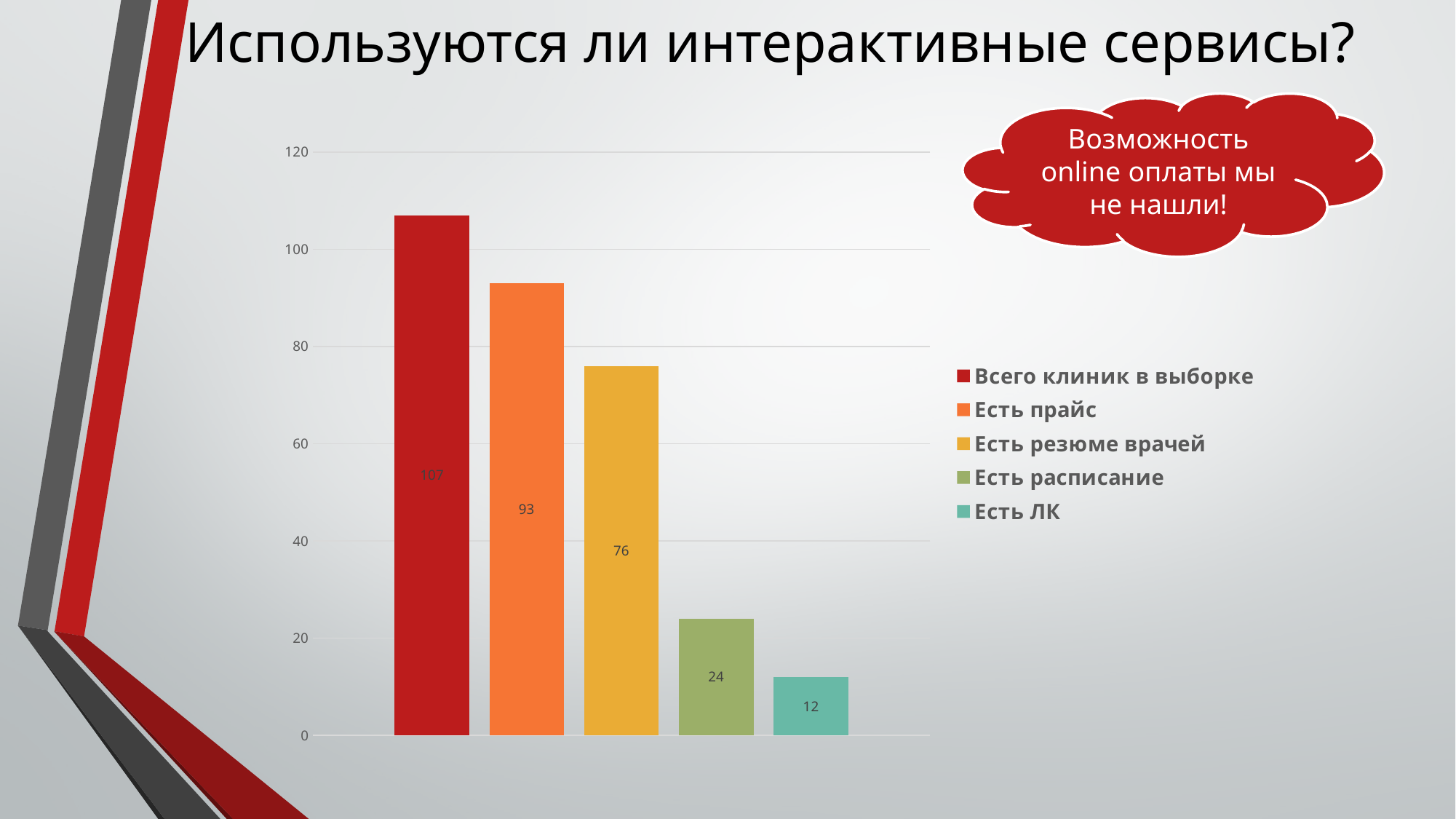
What is the difference between "Есть расписание" and "Есть ЛК"? 12 What is the difference between "Всего клиник в выборке" and "Есть прайс"? 14 Which series has the lowest value? Есть ЛК How many series does the legend list? 5 Which series has the highest value? Всего клиник в выборке What is the value for "Всего клиник в выборке"? 107 What is the value for "Есть ЛК"? 12 What is the value for "Есть прайс"? 93 Which is larger, "Есть резюме врачей" or "Есть расписание"? Есть резюме врачей What kind of chart is shown on the slide? Bar chart What is the value for "Есть расписание"? 24 What is the value for "Есть резюме врачей"? 76